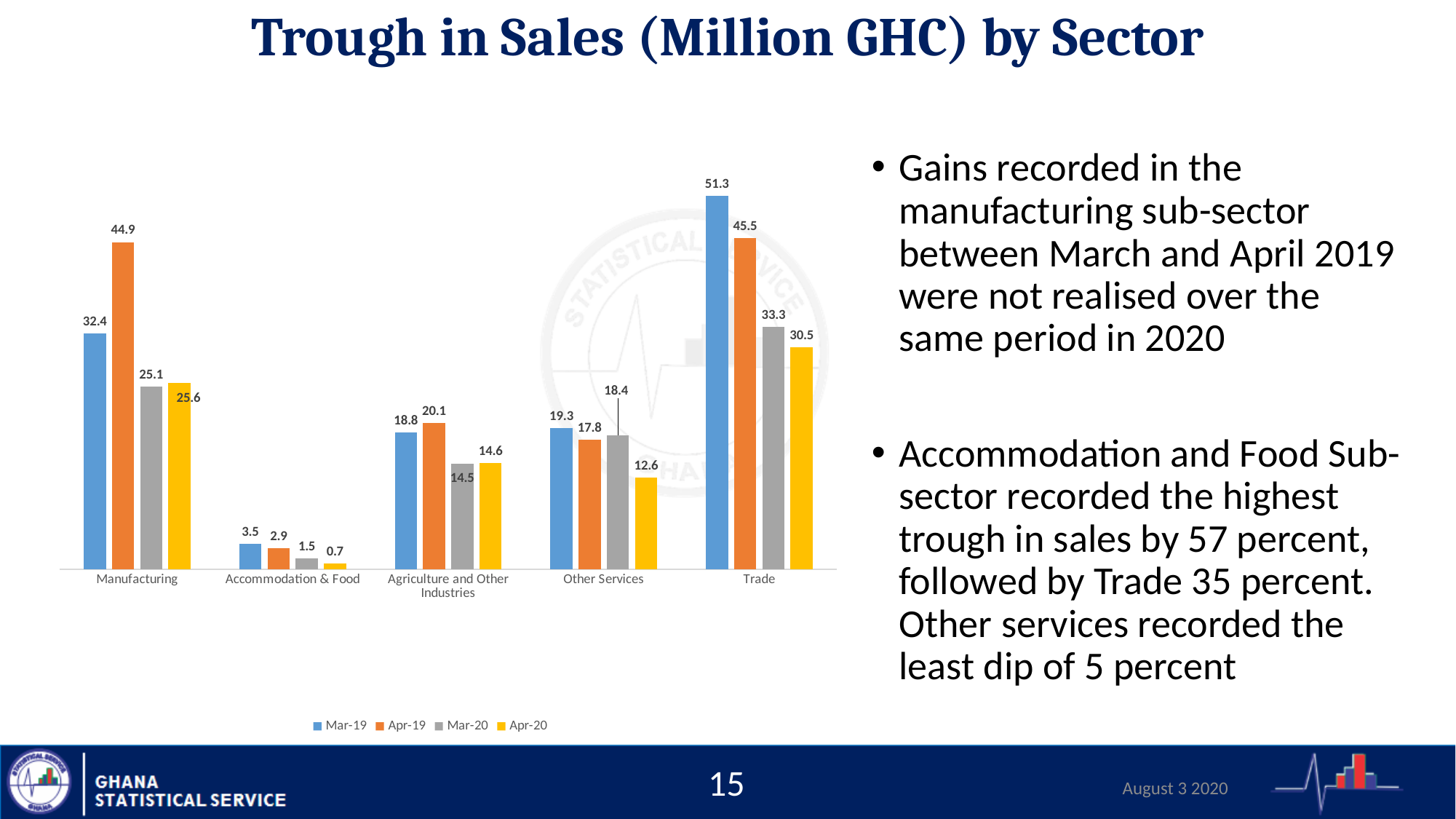
Which is larger for Agriculture and Other Industries: the Mar-19 value or the Apr-19 value? Apr-19 How many series does the legend list? 4 Which sector has the lowest Mar-20 value? Accommodation & Food What is the difference between the Mar-19 and Apr-20 values for Trade? 20.8 Which sector has the highest Apr-19 value? Trade What kind of chart is shown on the slide? Bar chart What is the Apr-20 value for Accommodation & Food? 0.7 What is the Mar-19 value for Trade? 51.3 What is the title of the chart on the slide? Trough in Sales (Million GHC) by Sector What is the Mar-20 value for Other Services? 18.4 What is the difference between the Apr-19 and Mar-19 values for Manufacturing? 12.5 How many sectors are shown on the x axis? 5